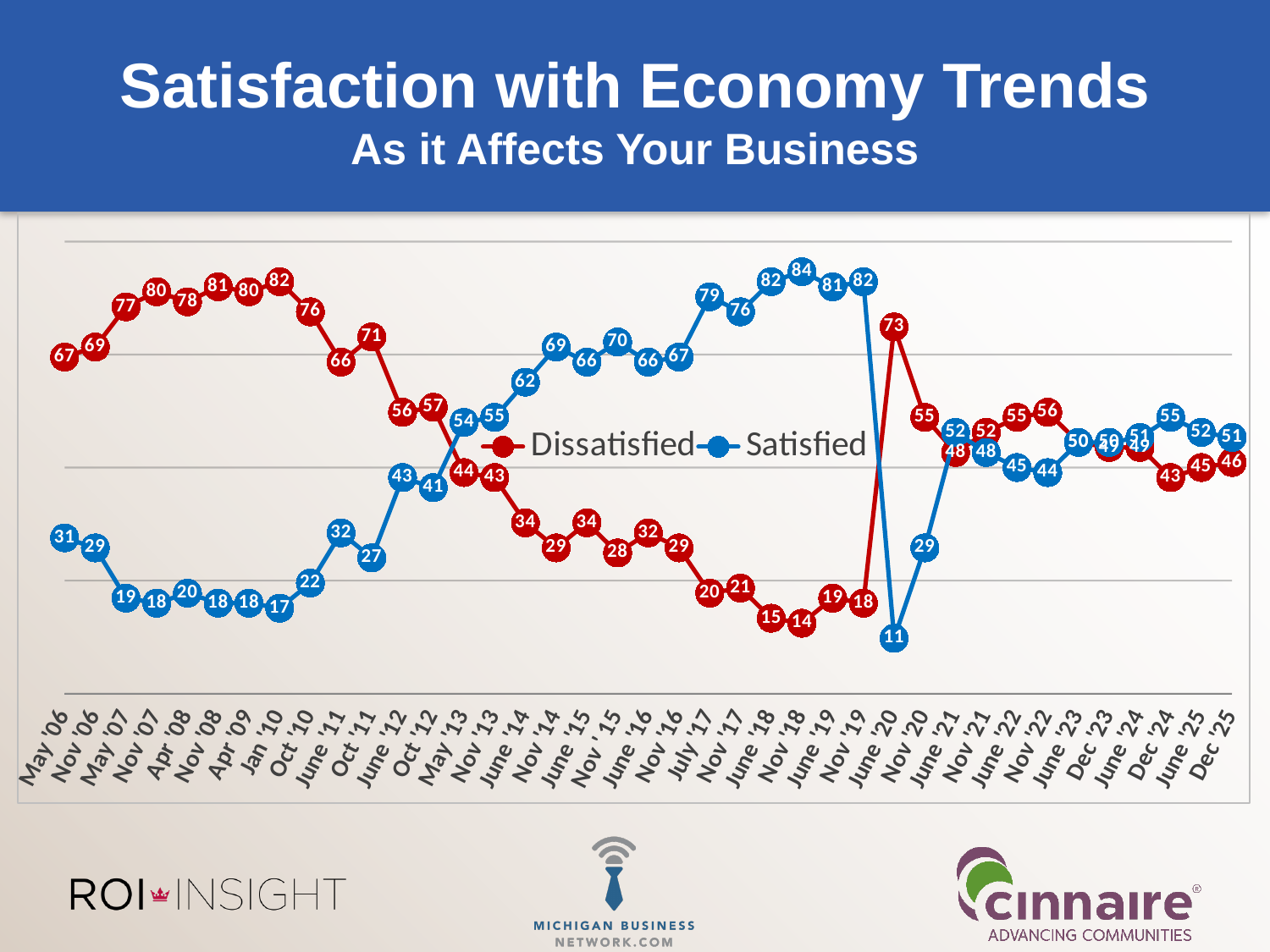
What are the two series named in the legend? Dissatisfied and Satisfied What is the Satisfied value for Dec '25? 51 Does the Dissatisfied series rise or fall between Jan '10 and Nov '18? Fall At which date does the Satisfied series reach its highest value? Nov '18 What type of chart is shown on the slide? Line chart At which date does the Satisfied series reach its lowest value? June '20 At which date does the Dissatisfied series reach its lowest value? Nov '18 What is the Satisfied value for Nov '18? 84 What is the Dissatisfied value for June '20? 73 How many series does the legend list? 2 What is the difference between the Dissatisfied and Satisfied values at June '20? 62 Which series has the larger value at Nov '19, Dissatisfied or Satisfied? Satisfied